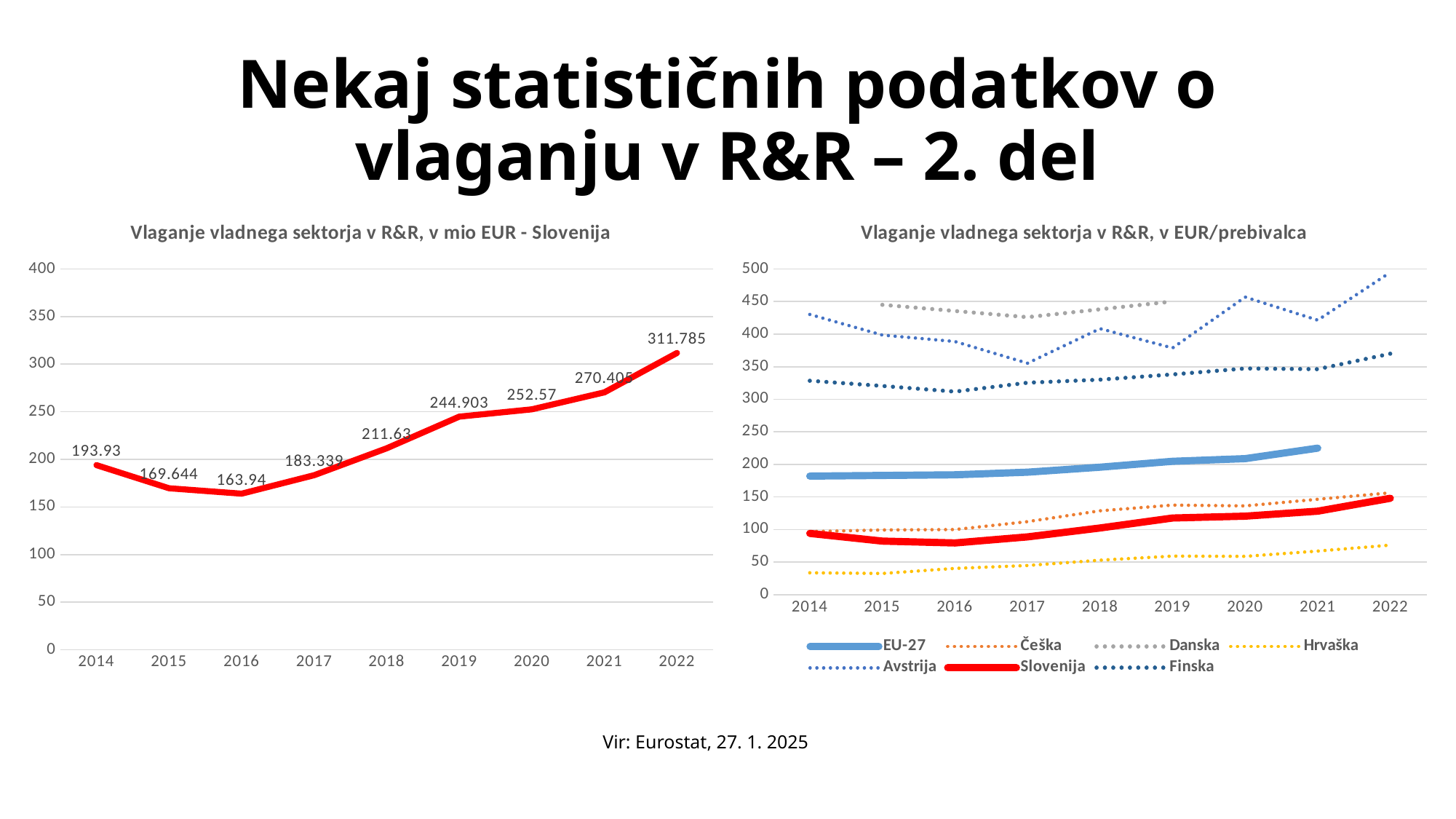
In the right chart 'Vlaganje vladnega sektorja v R&R, v EUR/prebivalca', which series is drawn as a thick solid red line? Slovenija In the right chart 'Vlaganje vladnega sektorja v R&R, v EUR/prebivalca', is the value for Hrvaška in 2014 greater or less than 50? less In the right chart 'Vlaganje vladnega sektorja v R&R, v EUR/prebivalca', how many series does the legend list? 7 What kind of chart is the left chart 'Vlaganje vladnega sektorja v R&R, v mio EUR - Slovenija'? line chart In the left chart 'Vlaganje vladnega sektorja v R&R, v mio EUR - Slovenija', which year has the lowest value? 2016 In the left chart 'Vlaganje vladnega sektorja v R&R, v mio EUR - Slovenija', what is the difference between the 2022 value and the 2014 value? 117.855 In the left chart 'Vlaganje vladnega sektorja v R&R, v mio EUR - Slovenija', what is the value for 2022? 311.785 In the left chart 'Vlaganje vladnega sektorja v R&R, v mio EUR - Slovenija', is the value for 2019 greater or less than 2015? greater In the right chart 'Vlaganje vladnega sektorja v R&R, v EUR/prebivalca', is the value for Avstrija in 2022 greater or less than 450? greater In the left chart 'Vlaganje vladnega sektorja v R&R, v mio EUR - Slovenija', what is the value for 2016? 163.94 In the left chart 'Vlaganje vladnega sektorja v R&R, v mio EUR - Slovenija', which year has the highest value? 2022 In the left chart 'Vlaganje vladnega sektorja v R&R, v mio EUR - Slovenija', how many years are plotted? 9